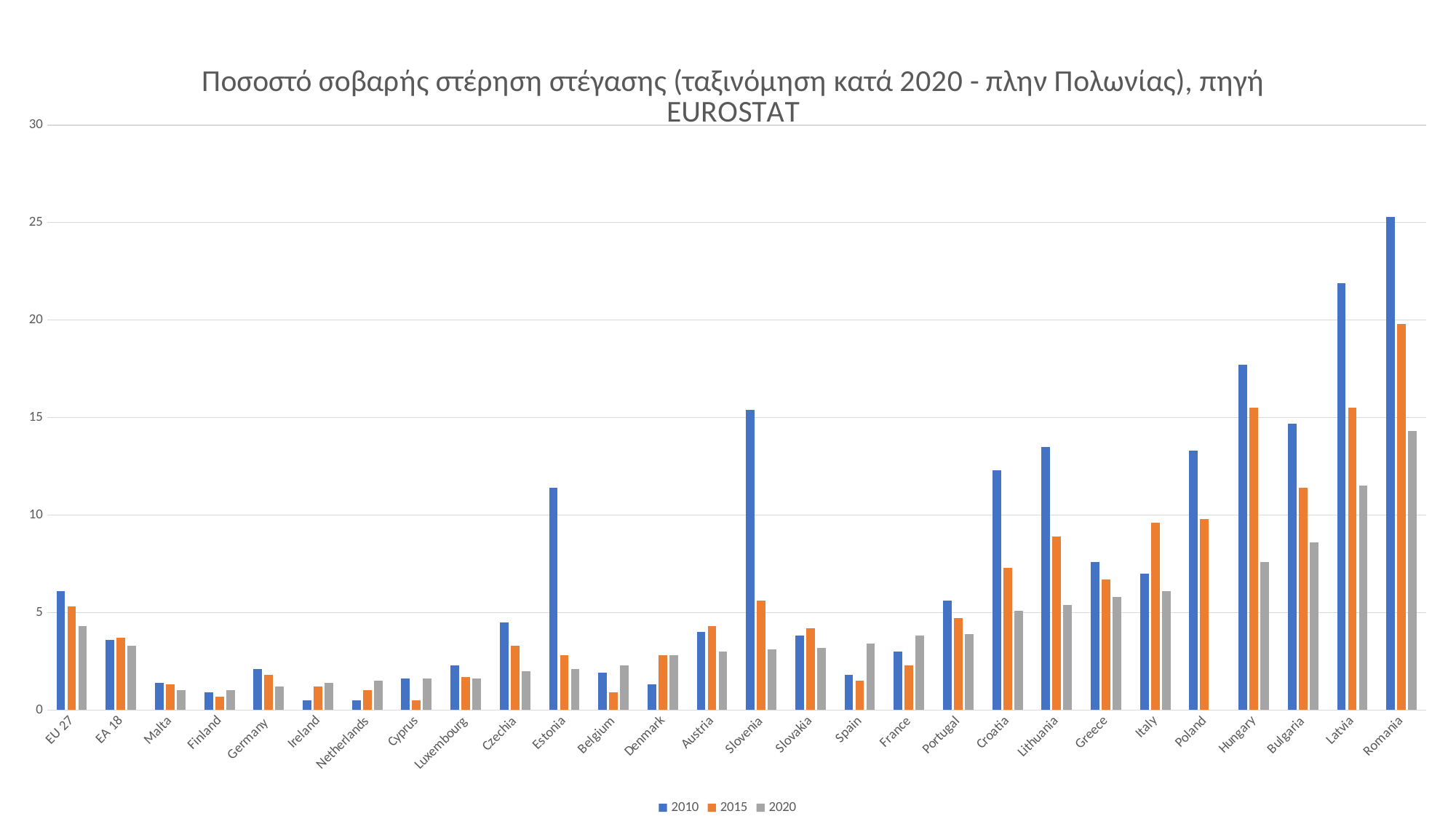
Which category has the highest value for the 2010 series? Romania Which is larger for Italy: the 2010 value or the 2015 value? 2015 Is the 2010 value for Romania greater or less than 20? greater Is the 2010 value for Estonia greater or less than 10? greater Which is larger for Slovenia: the 2010 value or the 2020 value? 2010 Is the 2015 value for Hungary greater or less than 10? greater How many series does the legend list? 3 Which country has no bar for the 2020 series? Poland Which category has the highest value for the 2020 series? Romania How many countries/categories are shown on the x axis? 28 What kind of chart is shown on the slide? bar chart